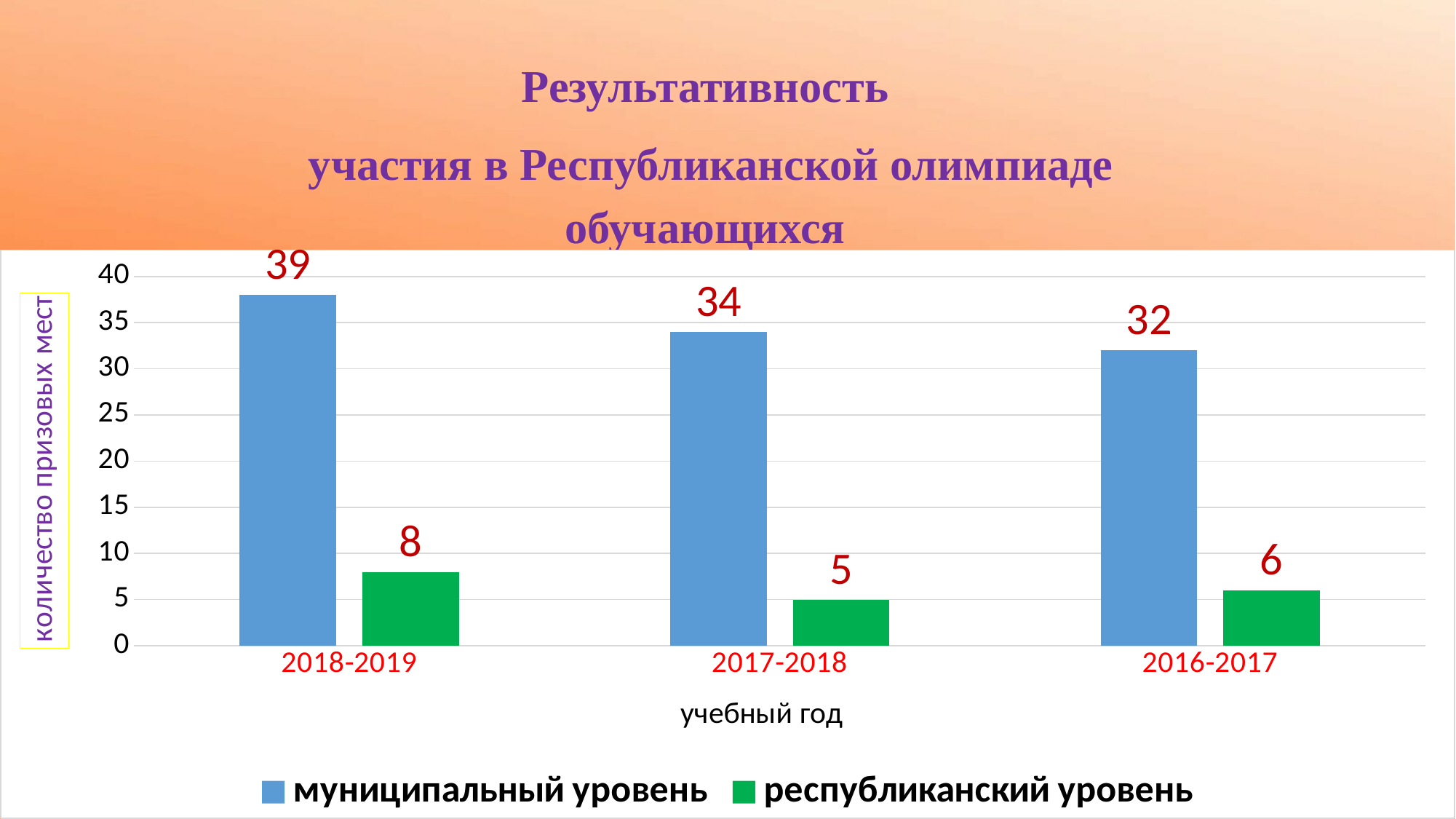
What is the difference between муниципальный уровень and республиканский уровень in 2018-2019? 31 What is the value for муниципальный уровень in 2016-2017? 32 Which is larger: республиканский уровень in 2018-2019 or in 2016-2017? 2018-2019 What is the value for республиканский уровень in 2017-2018? 5 Which academic year has the lowest value for республиканский уровень? 2017-2018 How many series does the legend list? 2 What is the value for республиканский уровень in 2016-2017? 6 Is the value for муниципальный уровень in 2017-2018 greater or less than 30? greater What is the value for муниципальный уровень in 2018-2019? 39 How many academic years are shown on the x axis? 3 What kind of chart is shown on the slide? bar chart Which academic year has the highest value for муниципальный уровень? 2018-2019